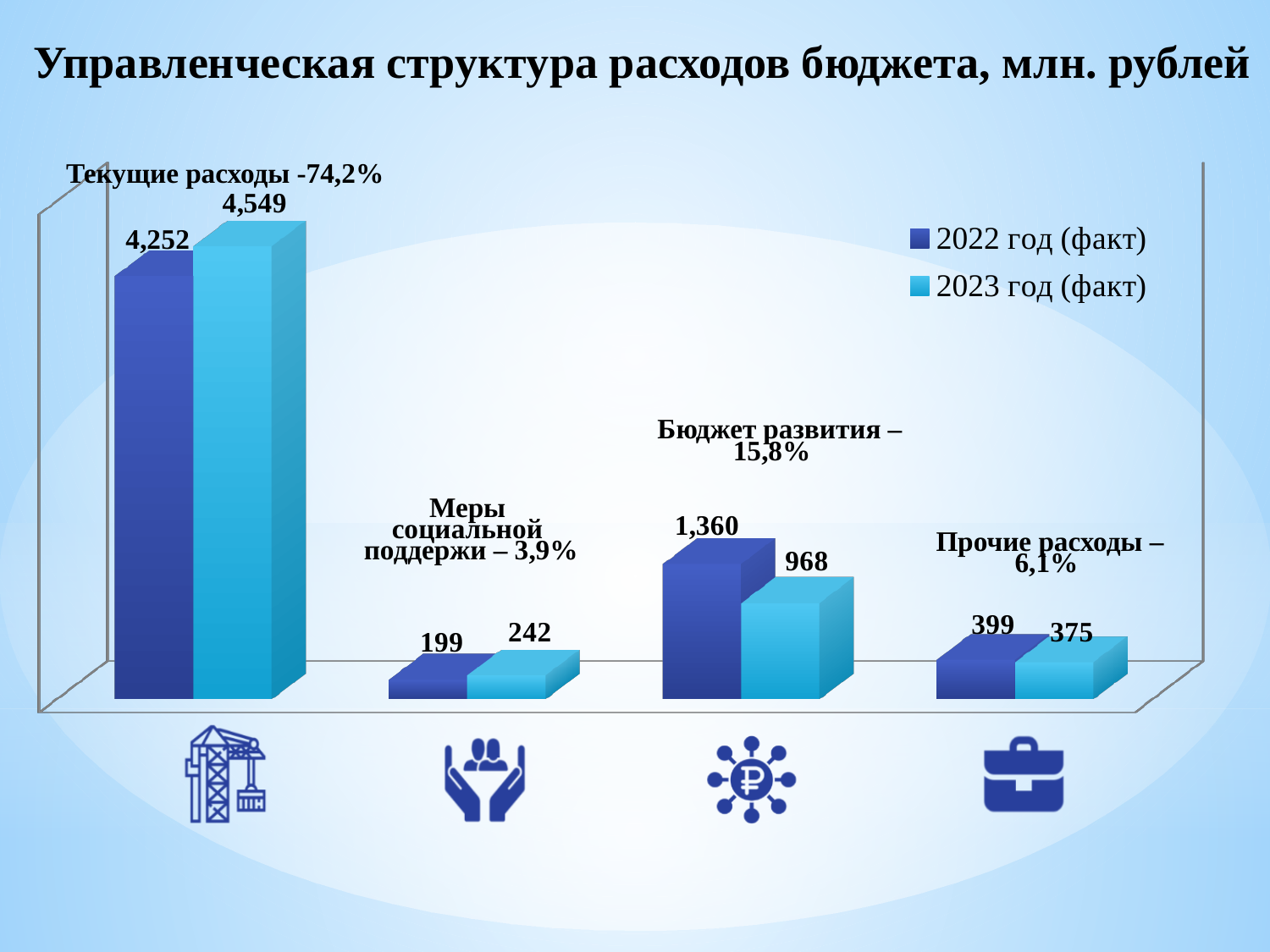
What is the value for Текущие расходы in the 2022 год (факт) series? 4,252 Which category has the highest value in the 2023 год (факт) series? Текущие расходы What is the difference between the 2022 год (факт) and 2023 год (факт) values for Бюджет развития? 392 How many series does the legend list? 2 How many categories are shown in the chart? 4 Which category has the lowest value in the 2022 год (факт) series? Меры социальной поддержки What is the value for Бюджет развития in the 2023 год (факт) series? 968 What is the value for Меры социальной поддержки in the 2022 год (факт) series? 199 What percentage share is shown next to the label Бюджет развития? 15,8% What kind of chart is shown on the slide? Bar chart What is the value for Текущие расходы in the 2023 год (факт) series? 4,549 Which is larger for Прочие расходы: the 2022 год (факт) value or the 2023 год (факт) value? 2022 год (факт)